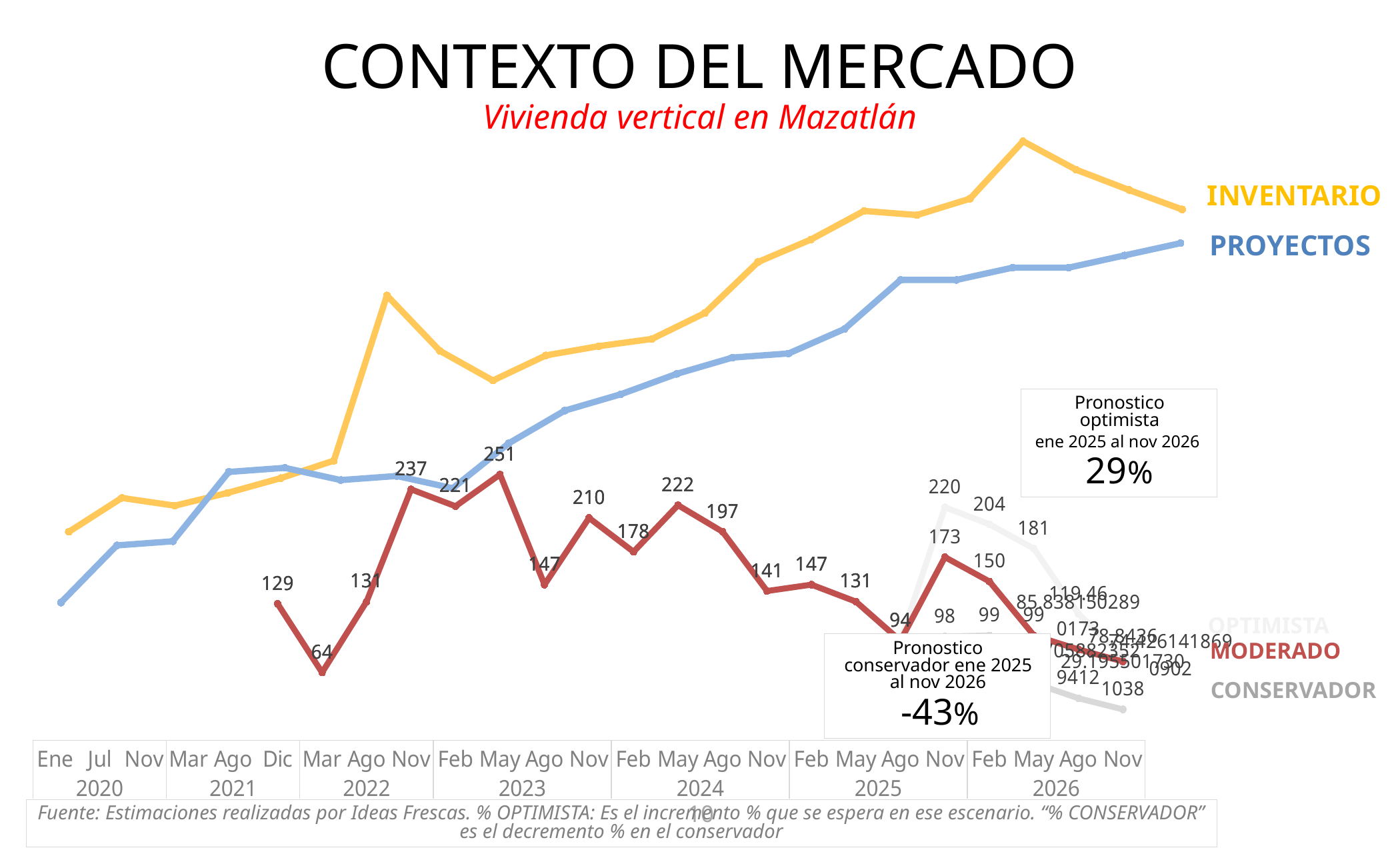
What is the highest data label shown on the MODERADO line? 251 How many years are labelled along the x axis? 7 Which is larger among the labelled MODERADO values 237 and 221? 237 What is the title of the slide's chart? CONTEXTO DEL MERCADO What is the difference between the highest (251) and lowest (64) labelled values on the MODERADO line? 187 How many series does the chart's legend list? 5 Which series reaches the highest point on the chart, INVENTARIO or PROYECTOS? INVENTARIO What is the highest data label shown on the OPTIMISTA line? 220 What percentage is given for the 'Pronostico optimista ene 2025 al nov 2026' annotation? 29% What kind of chart is shown on the slide? line chart What is the lowest data label shown on the MODERADO line? 64 Does the PROYECTOS line generally rise or fall from 2020 to 2026? rise